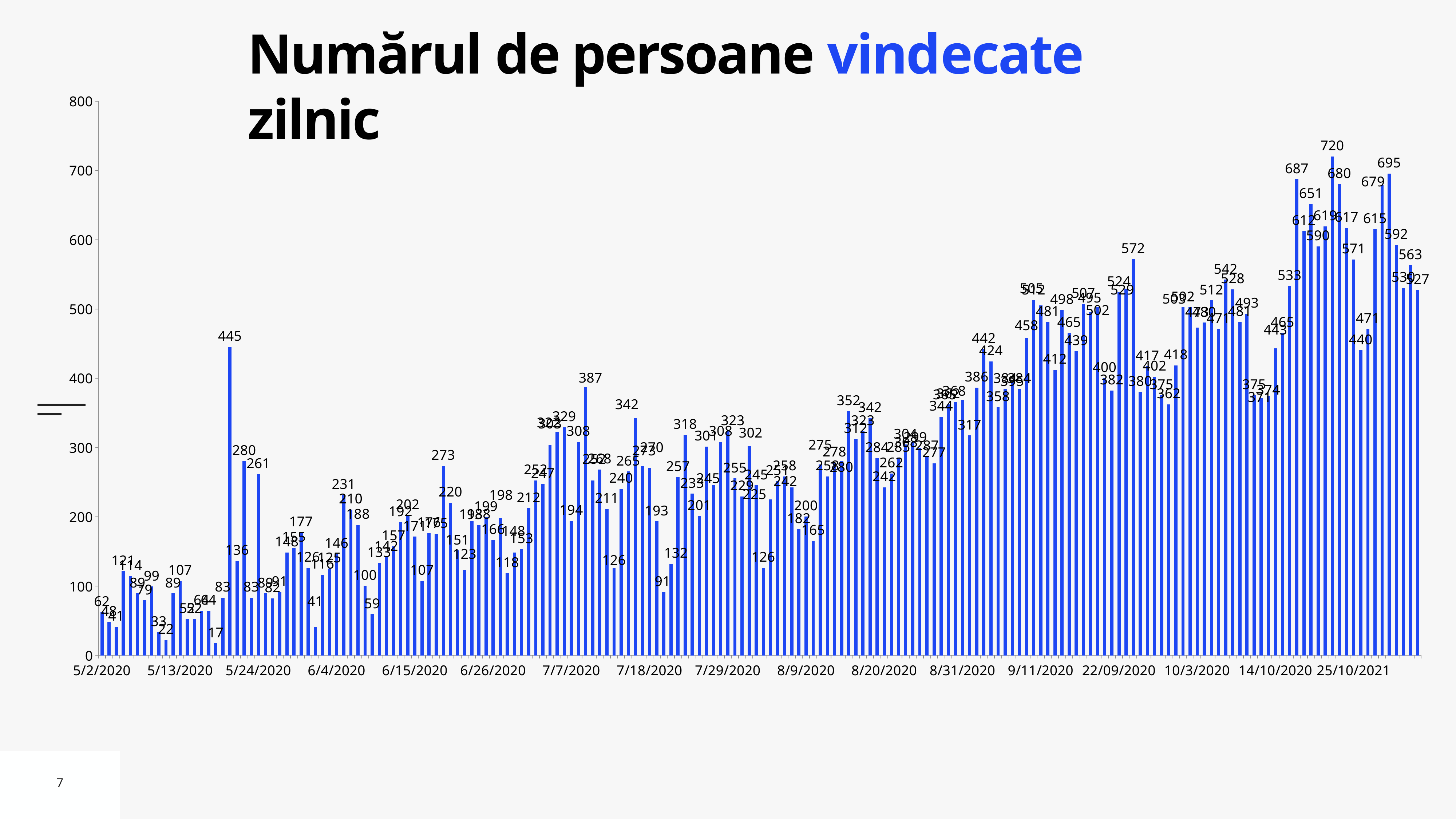
What is the difference between the bar labeled 445 and the bar labeled 387? 58 What is the difference between the highest labeled value (720) and the second highest (695)? 25 Is the tallest bar in the May 2020 section (labeled 445) greater or less than 400? greater Is the value for 5/2/2020 greater or less than 100? less What is the lowest value labeled on the chart? 17 What is the highest value shown on the vertical axis? 800 Which is larger, the bar labeled 687 or the bar labeled 651? 687 What is the value of the first bar, for 5/2/2020? 62 What is the title of the chart? Numărul de persoane vindecate zilnic Overall, do the values rise or fall from left to right along the x axis? rise What is the highest value labeled on the chart? 720 What kind of chart is shown on the slide? bar chart